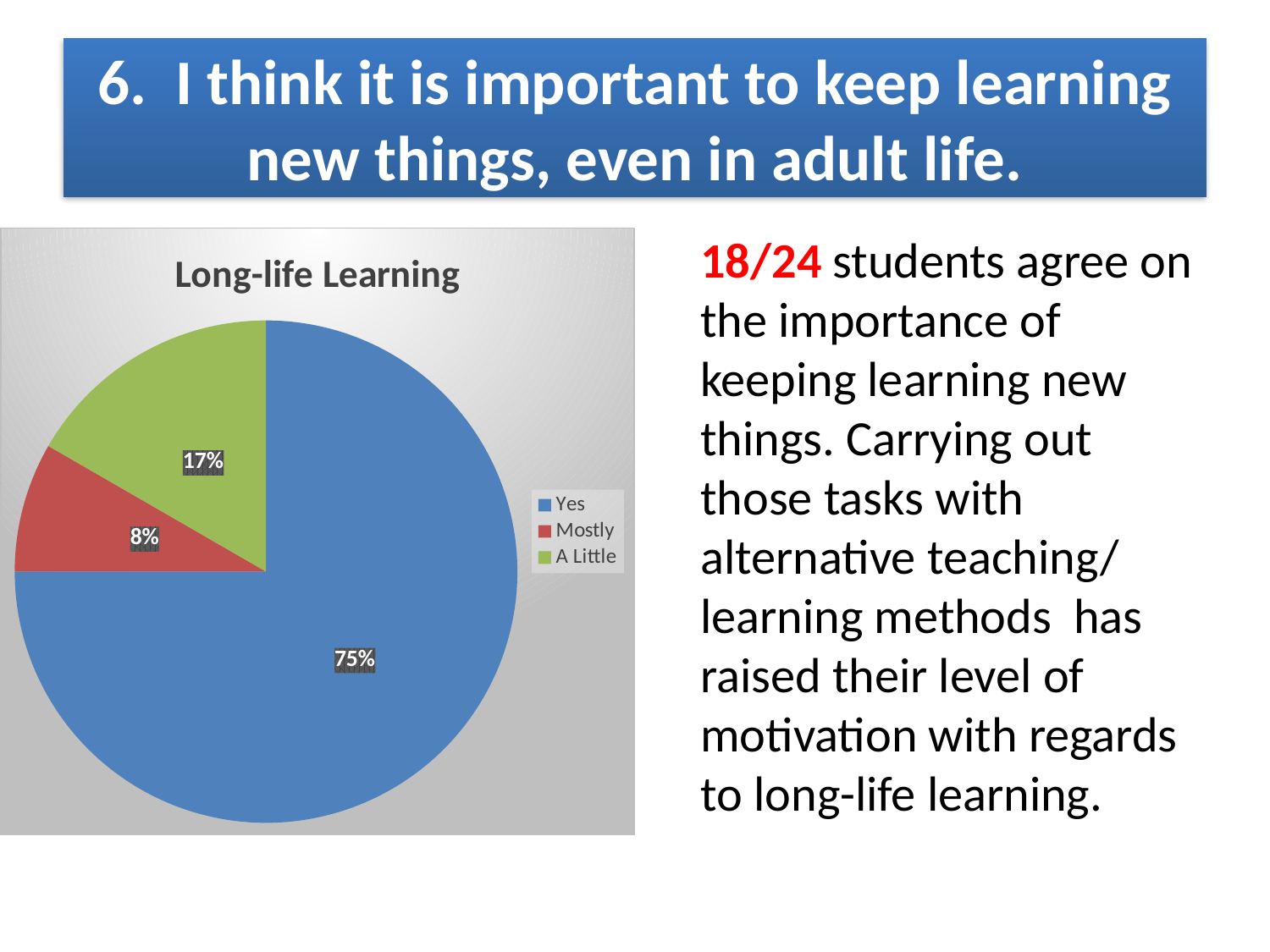
Is the share for "Yes" greater or less than 50%? greater What colour is the "Yes" slice in the pie chart? blue What is the difference in percentage points between the "Yes" slice and the "A Little" slice? 58 What percentage of the pie is the "A Little" slice? 17% What type of chart is shown on the slide? pie chart How many categories does the pie chart show? 3 What percentage of the pie is the "Yes" slice? 75% What percentage of the pie is the "Mostly" slice? 8% Which slice is larger, "A Little" or "Mostly"? A Little What is the title of the chart? Long-life Learning Which category has the smallest share of the pie? Mostly Which category has the largest share of the pie? Yes